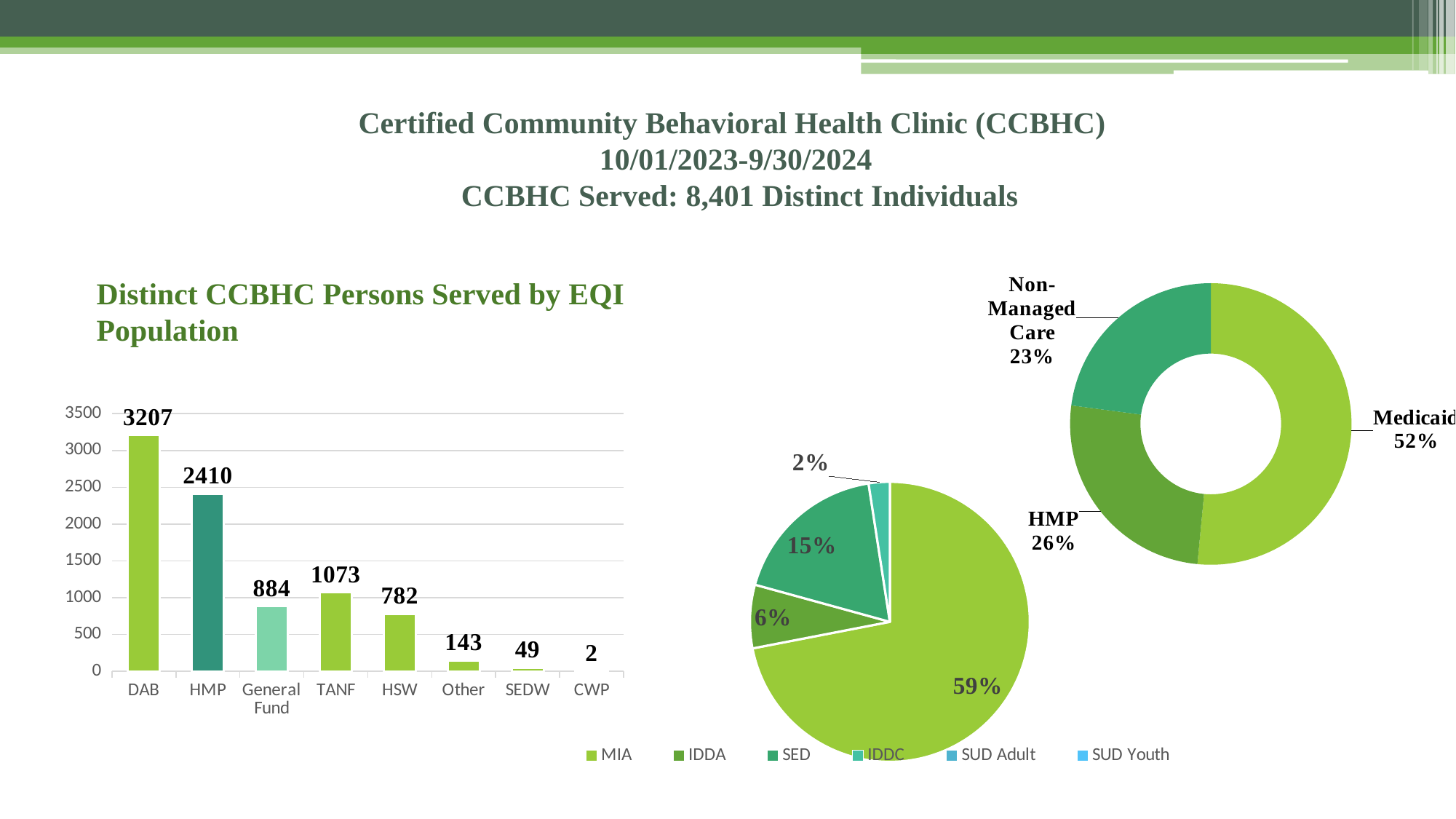
How many categories are shown in the bar chart 'Distinct CCBHC Persons Served by EQI Population'? 8 In the bar chart 'Distinct CCBHC Persons Served by EQI Population', which category has the highest value? DAB In the bar chart 'Distinct CCBHC Persons Served by EQI Population', which is larger, the value for General Fund or the value for HSW? General Fund In the donut chart on the right of the slide, which segment is the smallest? Non-Managed Care In the pie chart in the middle of the slide, what is the share of the largest slice? 59% In the bar chart 'Distinct CCBHC Persons Served by EQI Population', which category has the lowest value? CWP In the bar chart 'Distinct CCBHC Persons Served by EQI Population', what is the value for DAB? 3207 In the donut chart on the right of the slide, what share does Medicaid have? 52% What kind of chart is 'Distinct CCBHC Persons Served by EQI Population'? Bar chart How many series does the legend of the pie chart in the middle of the slide list? 6 In the bar chart 'Distinct CCBHC Persons Served by EQI Population', what is the value for TANF? 1073 In the bar chart 'Distinct CCBHC Persons Served by EQI Population', what is the difference between the values for DAB and HMP? 797